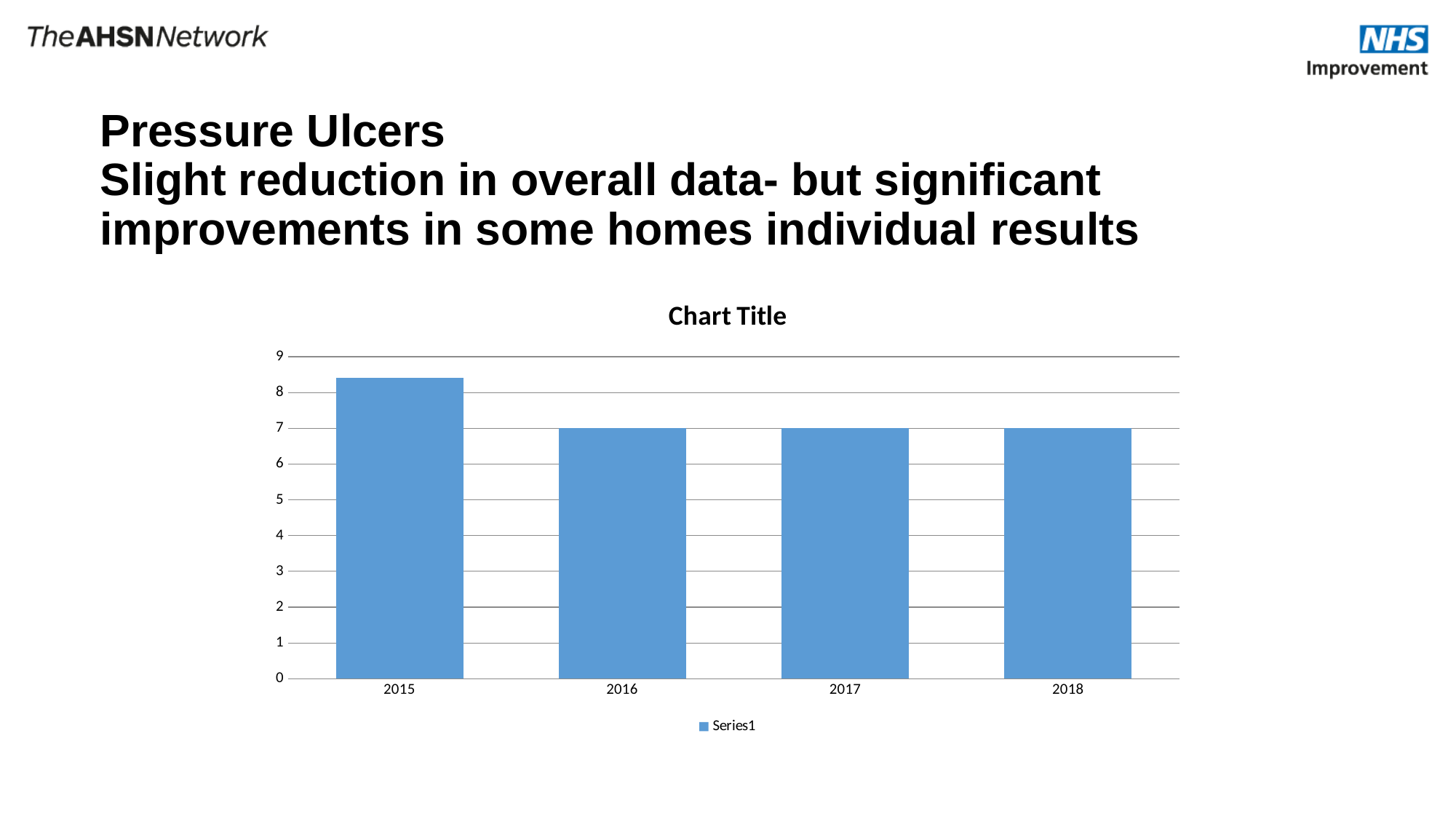
What is the value for 2018? 7 How many series does the legend list? 1 What is the value for 2016? 7 What kind of chart is shown? bar chart Which is larger, the value for 2015 or the value for 2018? 2015 Is the value for 2016 greater or less than 8? less Which is larger, the value for 2015 or the value for 2016? 2015 Is the value for 2015 greater or less than 8? greater Do the values rise or fall from 2015 to 2018? fall How many years are shown on the x axis? 4 What is the value for 2017? 7 Which year has the highest value? 2015